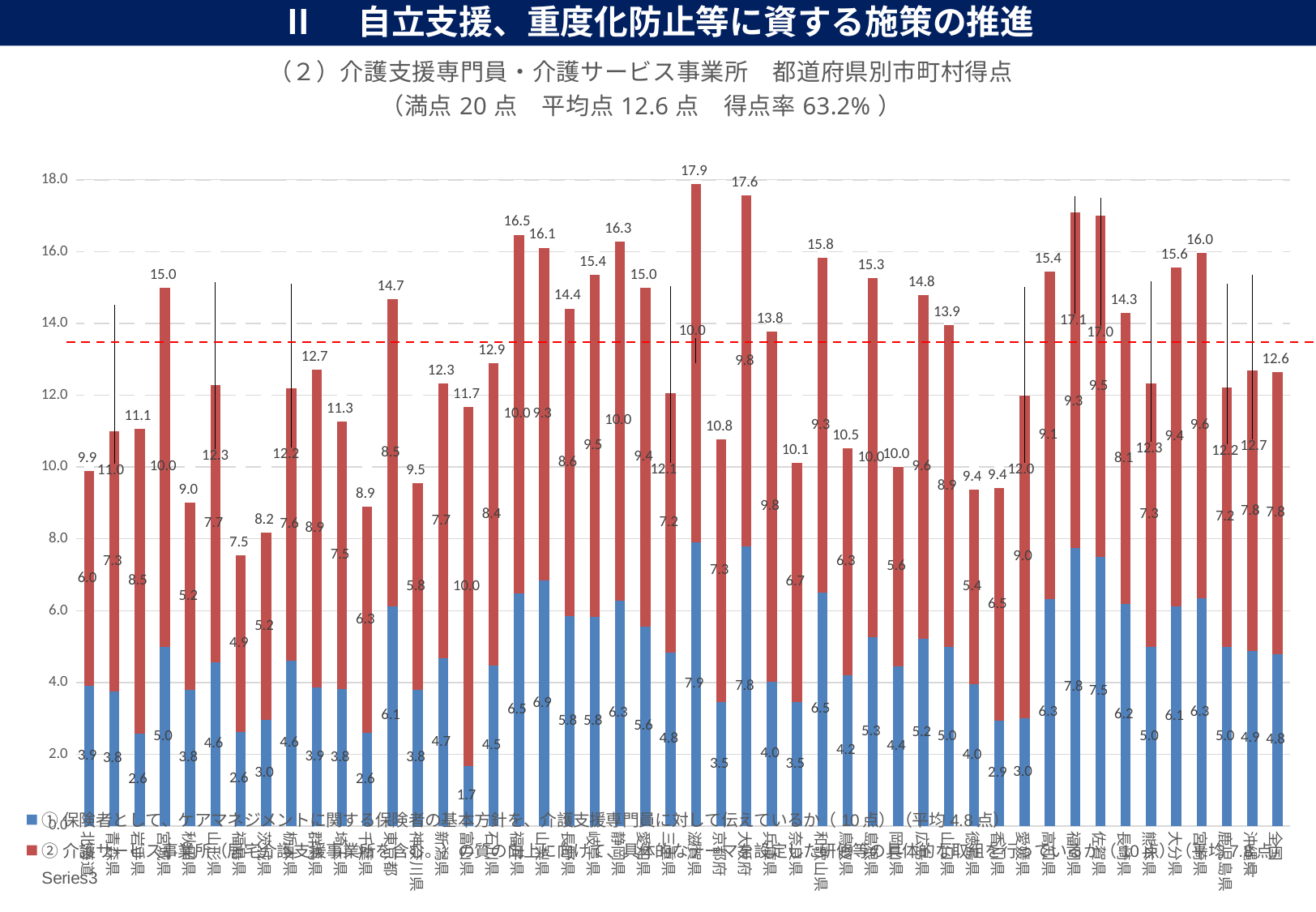
Which has the higher total score, 大阪府 or 東京都? 大阪府 What is the total score shown for 全国 (the last bar)? 12.6 What is the lowest total value labelled on any bar? 7.5 What kind of chart is shown on the slide? Stacked bar chart What is the highest total value labelled on any bar? 17.9 What is the difference between the total scores of 大阪府 and 東京都? 2.9 How many bars (categories) are plotted along the x axis? 48 What is the total score shown for 北海道 (the first bar)? 9.9 What is the blue (①) segment value for 北海道? 3.9 How many series does the legend list? 3 What is the total score shown for 東京都? 14.7 What is the total score shown for 大阪府? 17.6